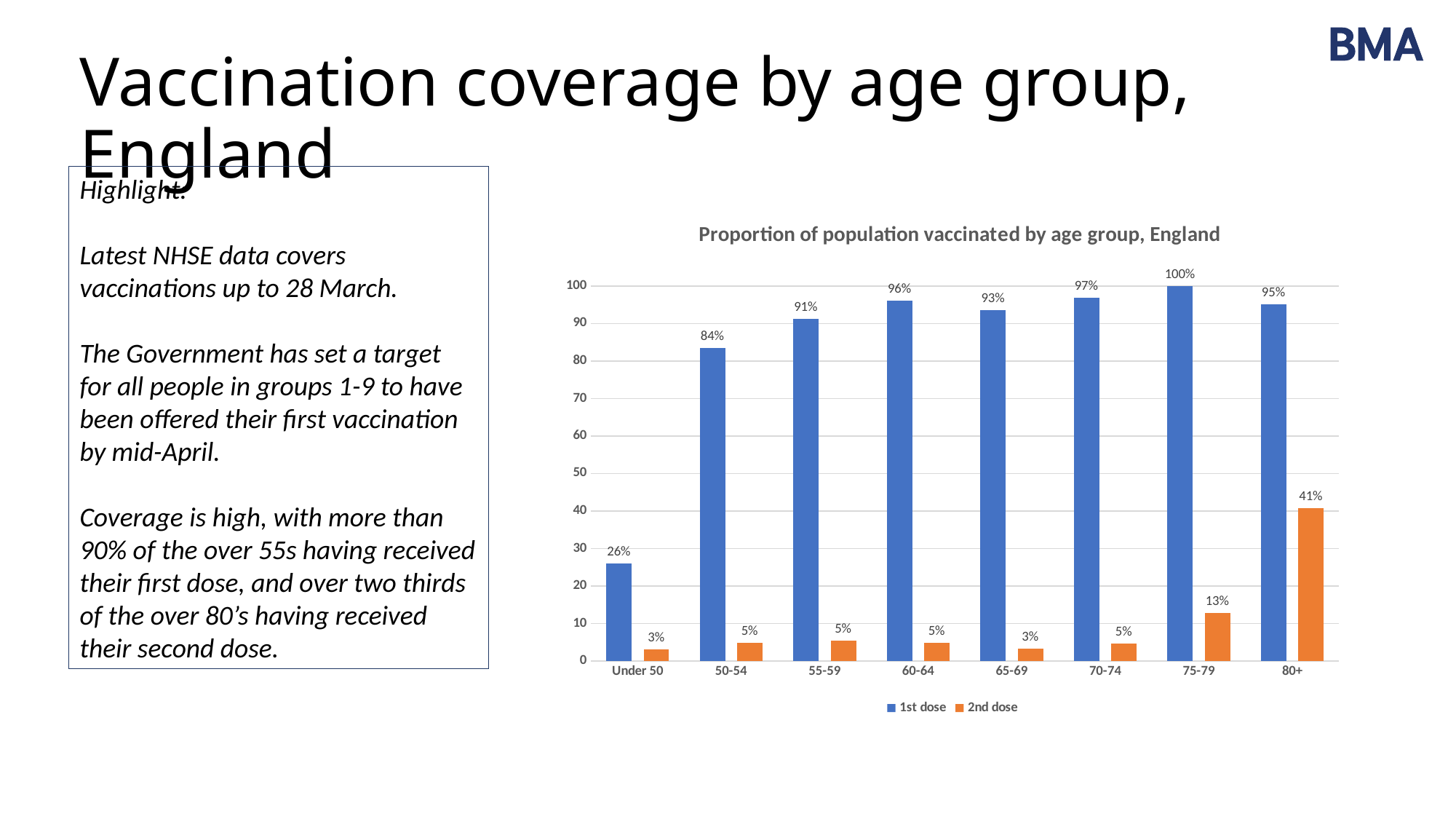
What is the 1st dose value for the Under 50 age group? 26% Which age group has the highest 2nd dose value? 80+ What is the 2nd dose value for the 80+ age group? 41% How many series does the legend list? 2 Which is larger, the 1st dose value for 60-64 or for 65-69? 60-64 What is the difference between the 1st dose and 2nd dose values for the 75-79 age group? 87% Which age group has the highest 1st dose value? 75-79 What kind of chart is shown on the slide? Bar chart What is the 1st dose value for the 50-54 age group? 84% What is the title of the chart? Proportion of population vaccinated by age group, England How many age groups are shown on the x axis? 8 Which age group has the lowest 1st dose value? Under 50